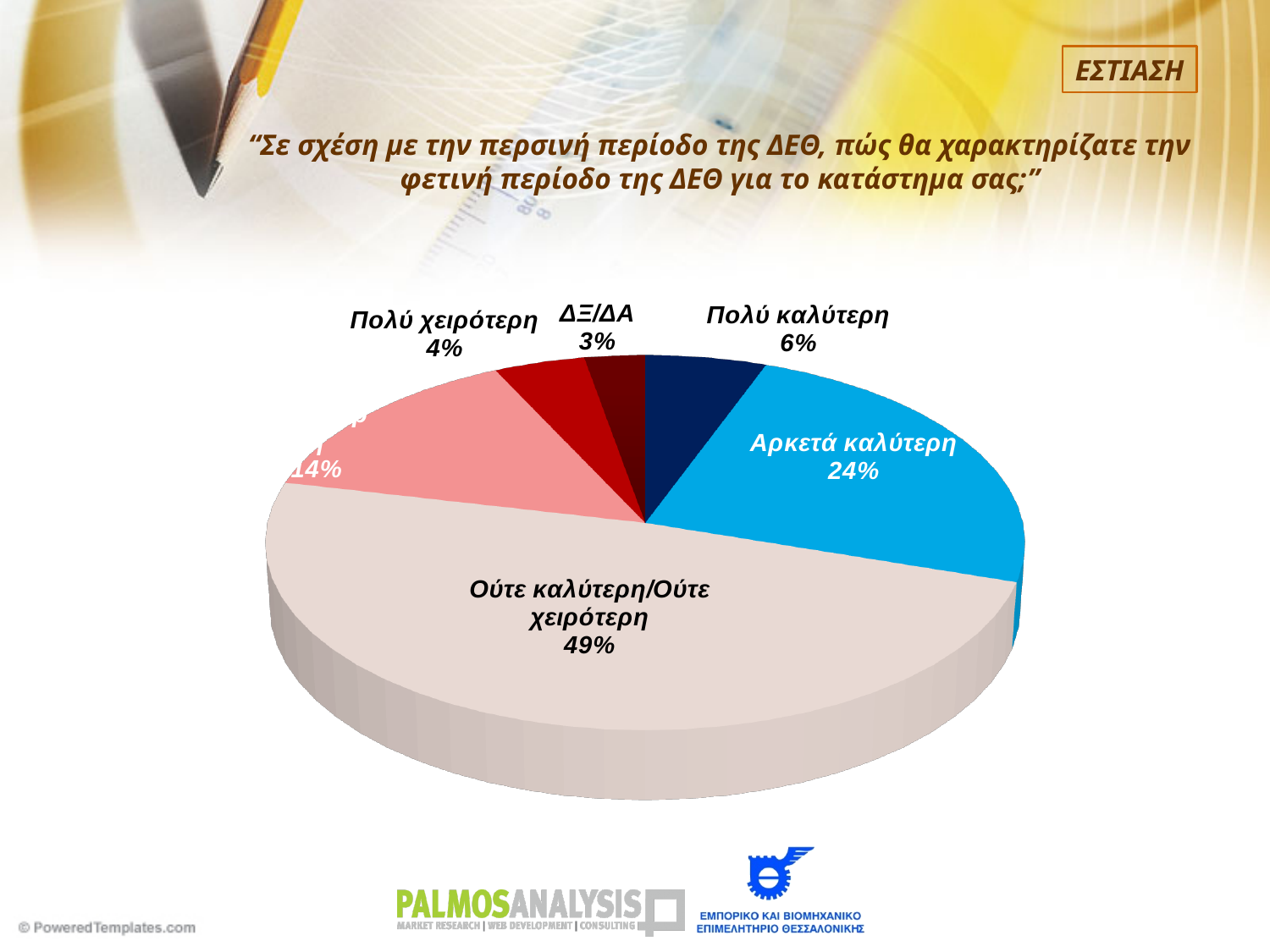
What colour is the "Αρκετά καλύτερη" slice? Light blue What percentage is shown for "Ούτε καλύτερη/Ούτε χειρότερη"? 49% What kind of chart is shown on the slide? Pie chart How many percentage points larger is "Ούτε καλύτερη/Ούτε χειρότερη" than "Αρκετά καλύτερη"? 25 percentage points What percentage is shown for "Αρκετά καλύτερη"? 24% Which category has the smallest share of the pie? ΔΞ/ΔΑ Which is larger, the share for "Πολύ καλύτερη" or the share for "Πολύ χειρότερη"? Πολύ καλύτερη What percentage is shown for "ΔΞ/ΔΑ"? 3% Which category has the largest share of the pie? Ούτε καλύτερη/Ούτε χειρότερη What percentage is shown for "Πολύ καλύτερη"? 6% What percentage is shown for "Πολύ χειρότερη"? 4% How many slices does the pie chart have? 6